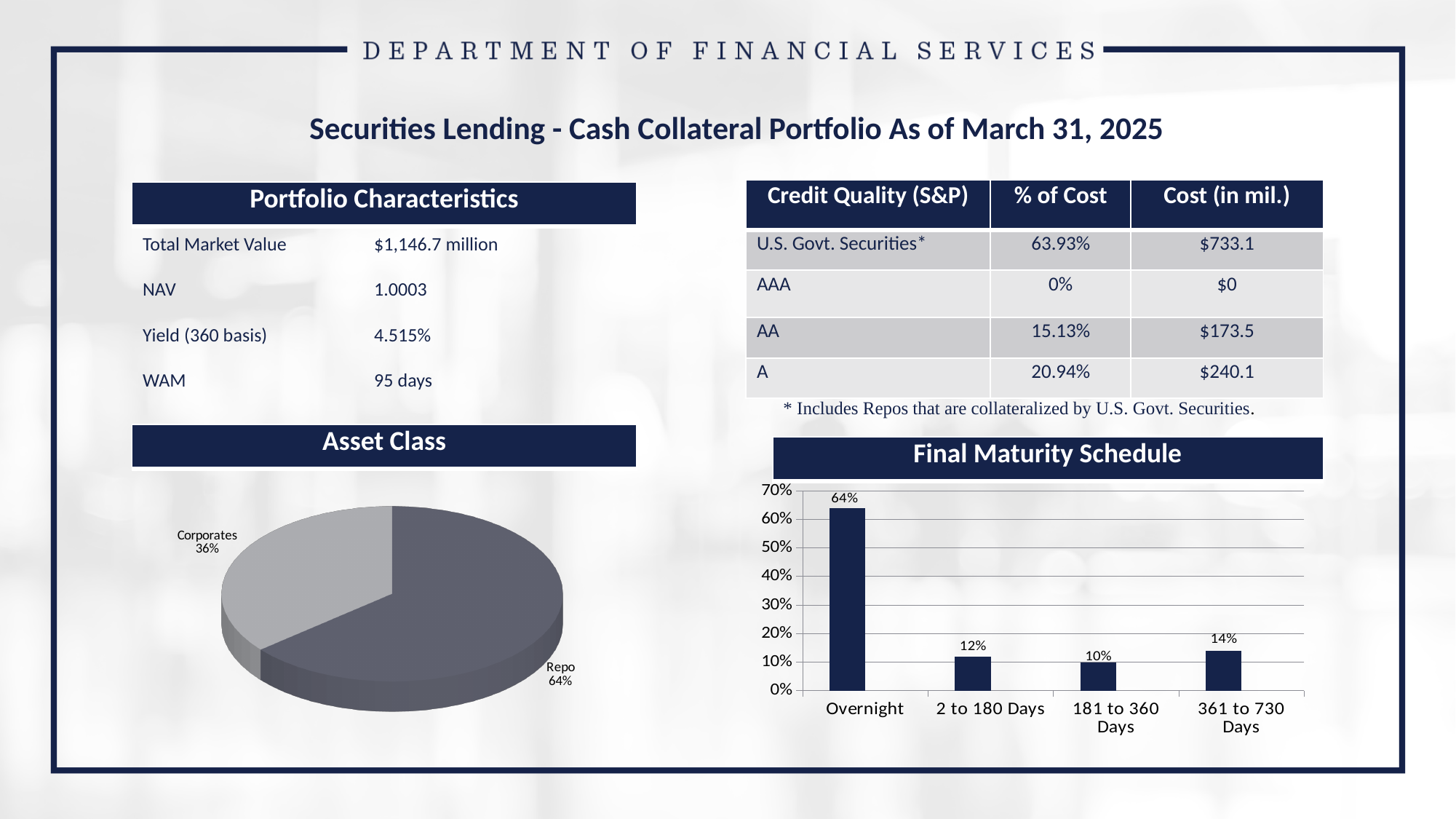
How many slices does the Asset Class pie chart have? 2 In the Final Maturity Schedule chart, what is the value for 181 to 360 Days? 10% In the Final Maturity Schedule chart, what is the difference between the Overnight value and the 361 to 730 Days value? 50% What kind of chart is the Final Maturity Schedule chart? Bar chart How many categories are shown in the Final Maturity Schedule chart? 4 In the Asset Class pie chart, what share does Corporates have? 36% What kind of chart is the Asset Class chart? Pie chart In the Final Maturity Schedule chart, which category has the lowest value? 181 to 360 Days In the Asset Class pie chart, which slice is larger, Repo or Corporates? Repo In the Final Maturity Schedule chart, what is the value for Overnight? 64% In the Final Maturity Schedule chart, which category has the highest value? Overnight In the Asset Class pie chart, what share does Repo have? 64%